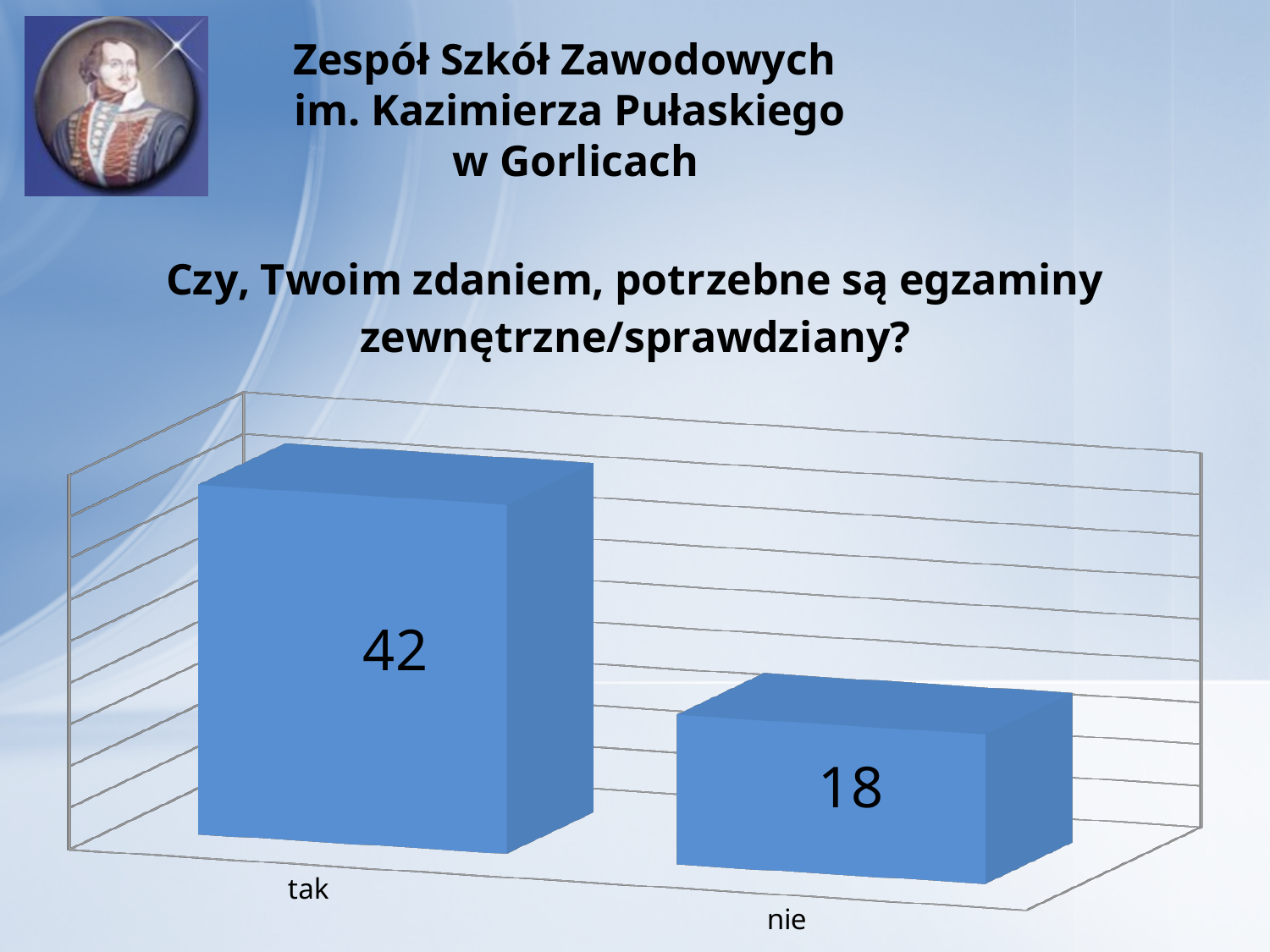
What colour are the bars in the chart? blue How many categories are shown in the chart? 2 Which category has the highest value? tak What is the difference between the values for "tak" and "nie"? 24 Do the values rise or fall from left to right along the x axis? fall Which is larger, the value for "tak" or the value for "nie"? tak Which category has the lowest value? nie What question does the chart on the slide answer? Czy, Twoim zdaniem, potrzebne są egzaminy zewnętrzne/sprawdziany? What kind of chart is shown on the slide? bar chart What is the value for "nie"? 18 What is the total of the two values shown in the chart? 60 What is the value for "tak"? 42